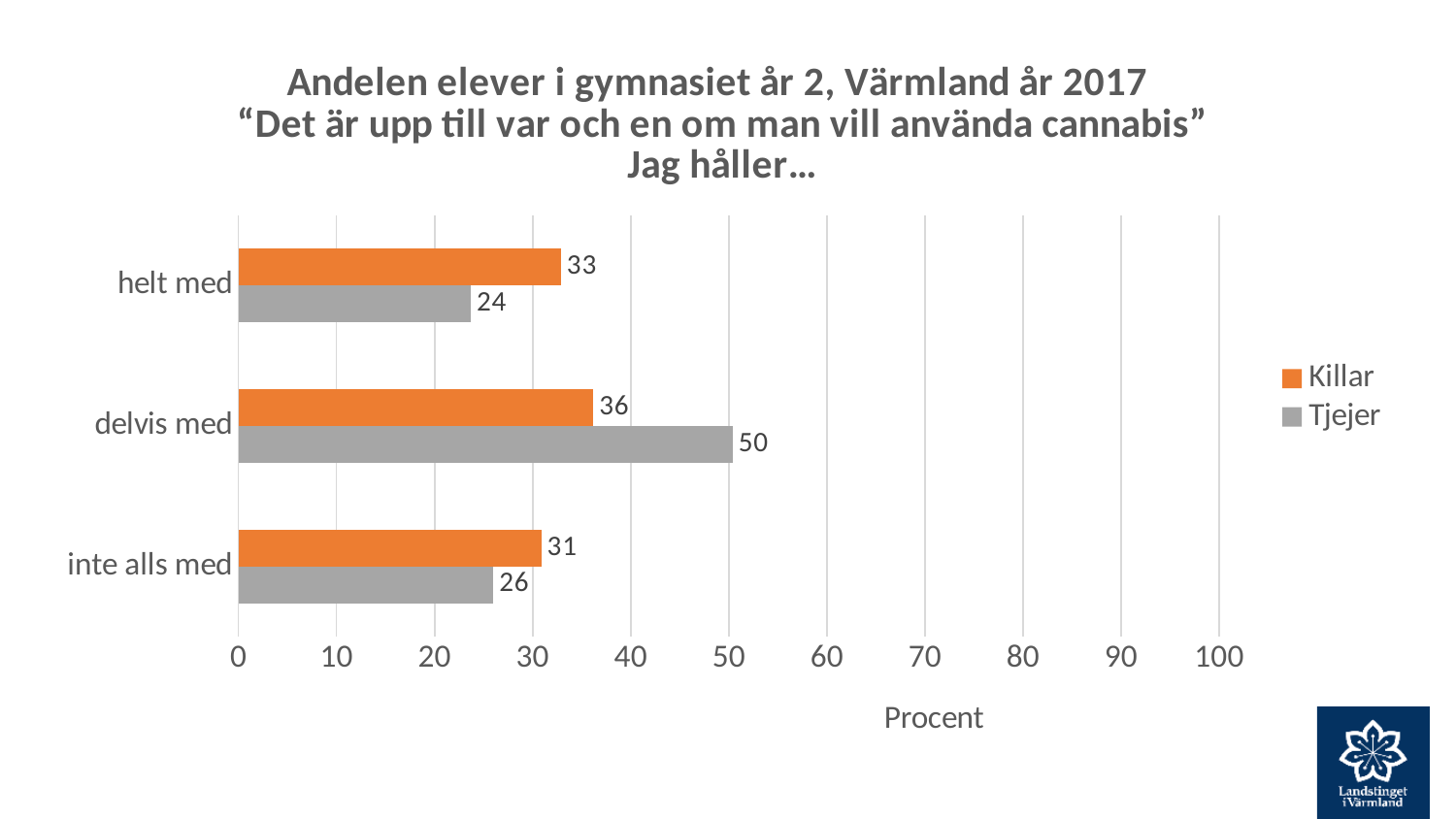
What is the value for Tjejer in the "delvis med" category? 50 What is the value for Killar in the "helt med" category? 33 How many series does the legend list? 2 How many categories are shown on the chart? 3 What is the difference between the Tjejer and Killar values in the "delvis med" category? 14 Which category has the lowest value for Killar? inte alls med What label is shown on the horizontal axis? Procent Which category has the highest value for Tjejer? delvis med In the "helt med" category, which series has the larger value, Killar or Tjejer? Killar What is the value for Tjejer in the "inte alls med" category? 26 What kind of chart is shown on the slide? bar chart Is the value for Tjejer in the "helt med" category greater or less than 30? less